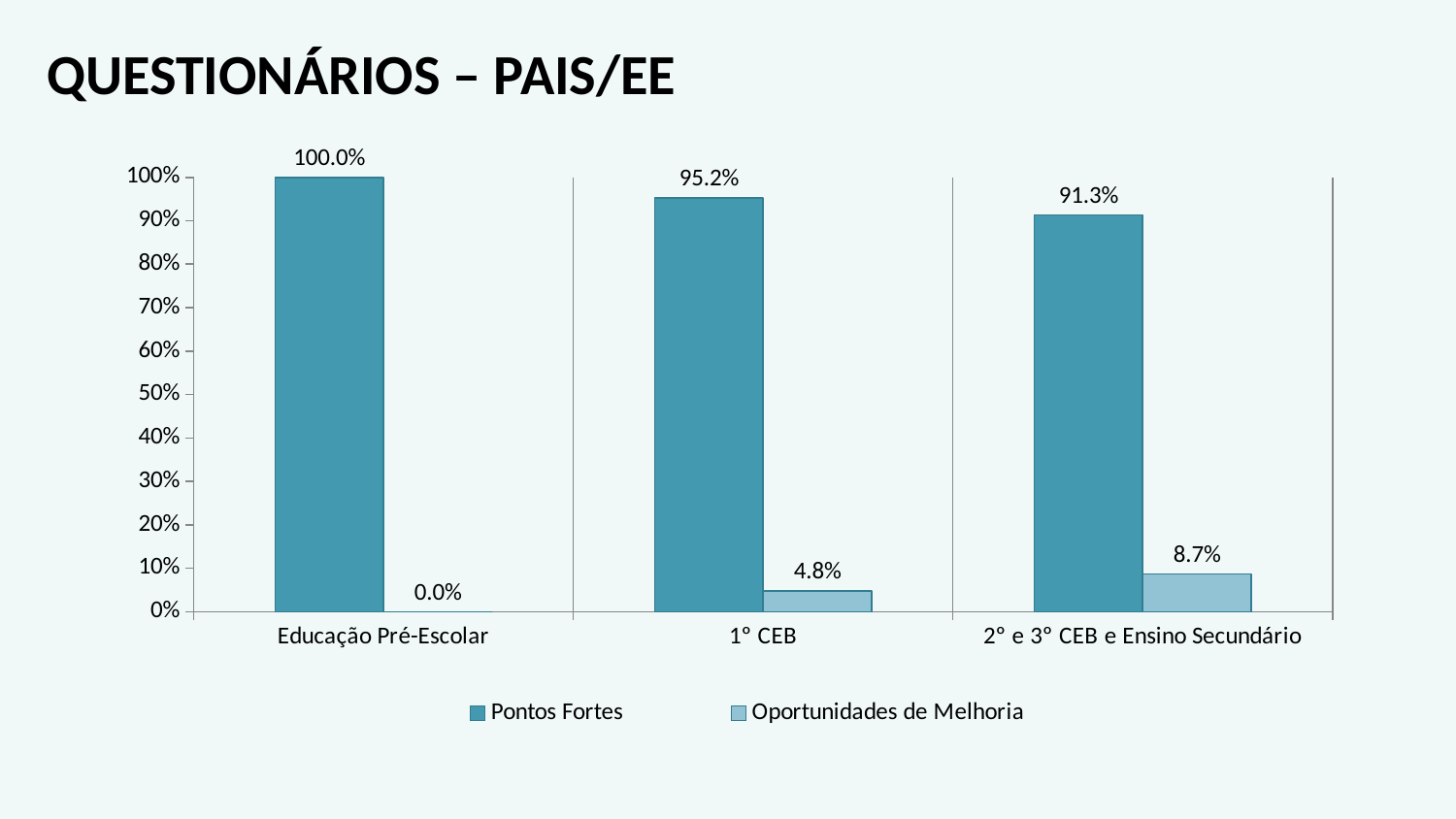
What kind of chart is shown on the slide? Bar chart What is the value of Oportunidades de Melhoria for Educação Pré-Escolar? 0.0% How many series does the legend list? 2 What is the value of Pontos Fortes for Educação Pré-Escolar? 100.0% What is the difference between Pontos Fortes for 1° CEB and for 2° e 3° CEB e Ensino Secundário? 3.9% How many categories are shown on the x axis? 3 What is the value of Pontos Fortes for 2° e 3° CEB e Ensino Secundário? 91.3% What is the value of Oportunidades de Melhoria for 1° CEB? 4.8% Which category has the lowest value for Oportunidades de Melhoria? Educação Pré-Escolar Do the Pontos Fortes values rise or fall from left to right along the x axis? Fall Which is larger: Oportunidades de Melhoria for 1° CEB or for 2° e 3° CEB e Ensino Secundário? 2° e 3° CEB e Ensino Secundário Which category has the highest value for Pontos Fortes? Educação Pré-Escolar